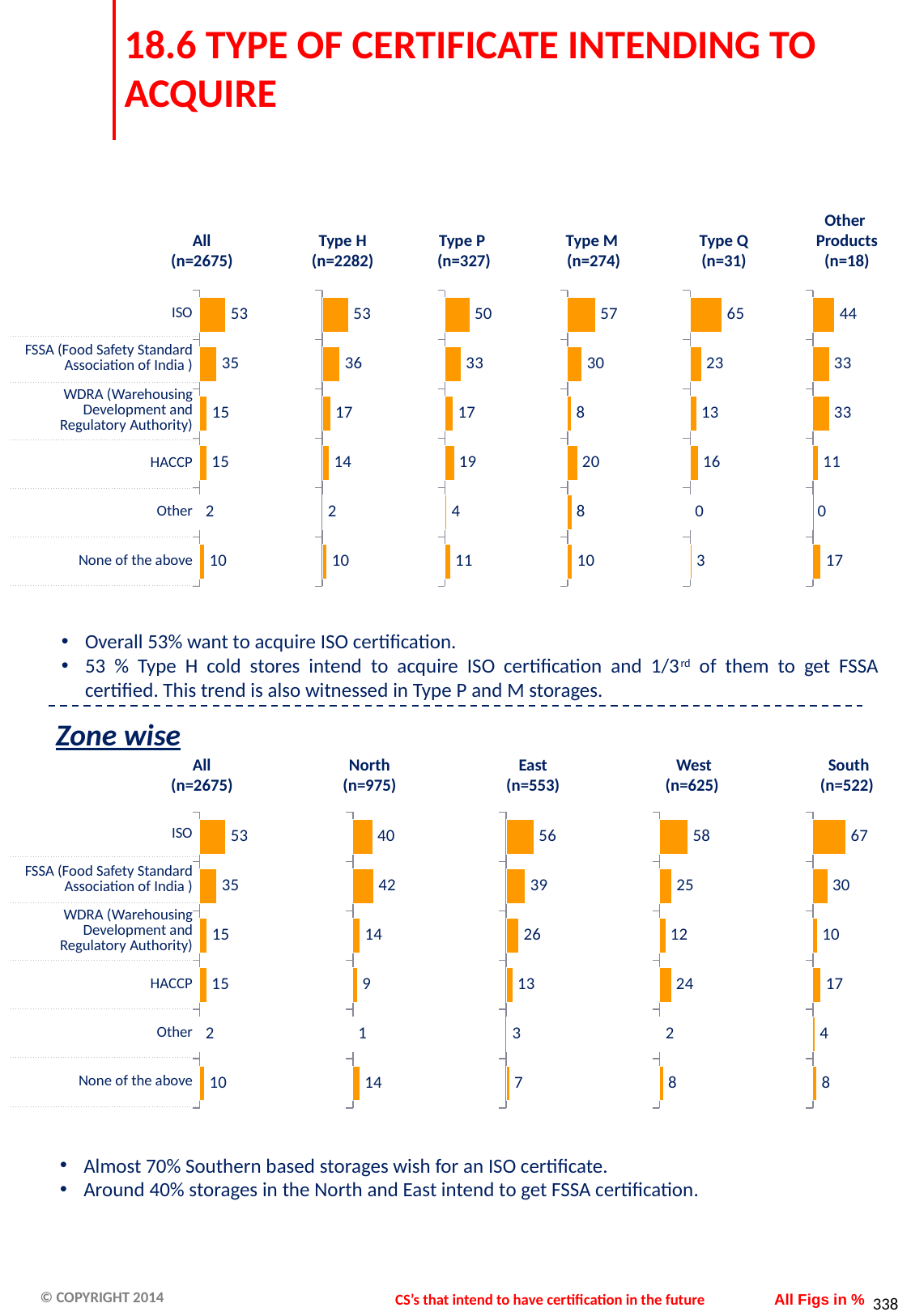
In the Zone wise section, what is the HACCP value in the West (n=625) chart? 24 In the top section (by type), which category has the lowest value in the Type H (n=2282) chart? Other In the Zone wise section, what is the ISO value in the South (n=522) chart? 67 What kind of chart is used throughout the slide? Bar chart How many certificate categories are listed in each chart on the slide? 6 In the top section (by type), what is the 'None of the above' value in the Other Products (n=18) chart? 17 In the Zone wise section, which is larger in the East (n=553) chart: WDRA or HACCP? WDRA In the Zone wise section, what is the difference between the FSSA and ISO values in the North (n=975) chart? 2 In the top section (by type), what is the difference between the ISO and FSSA values in the All (n=2675) chart? 18 In the top section (by type), which type chart shows the highest ISO value? Type Q In the top section (by type), what is the ISO value in the Type Q (n=31) chart? 65 In the Zone wise section, which zone chart shows the highest ISO value? South